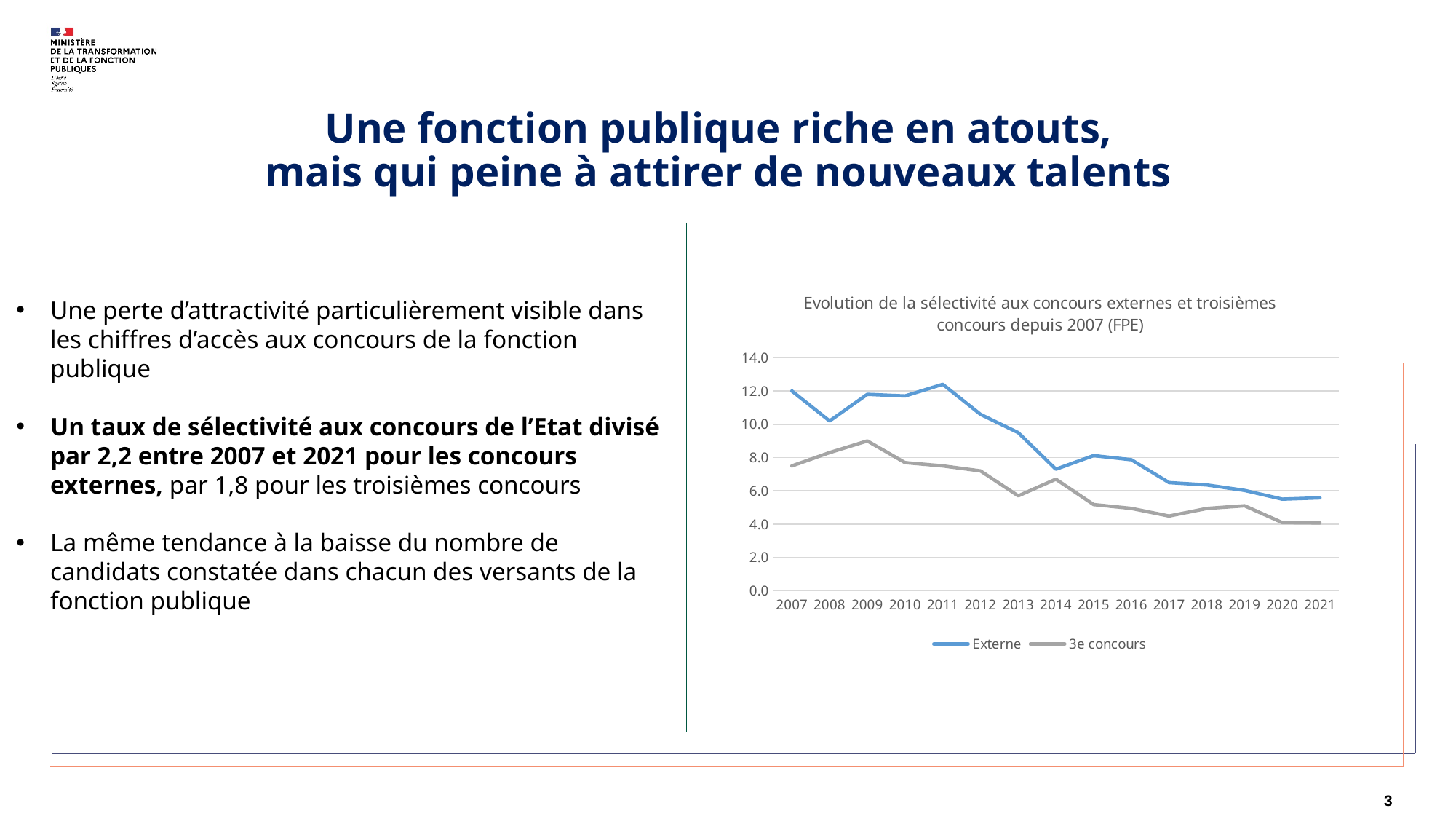
Is the value for Externe in 2011 greater or less than 10.0? greater How many years are plotted along the x axis of the chart? 15 What kind of chart is shown on the slide? Line chart In which year does the Externe series reach its highest value? 2011 Is the value for 3e concours in 2021 greater or less than 6.0? less Is the value for 3e concours in 2009 greater or less than 8.0? greater In 2011, which series has the larger value, Externe or 3e concours? Externe Overall, do the values of the Externe series rise or fall from 2007 to 2021? Fall In which year does the 3e concours series reach its highest value? 2009 Which series is drawn in grey in the chart? 3e concours How many series does the chart legend list? 2